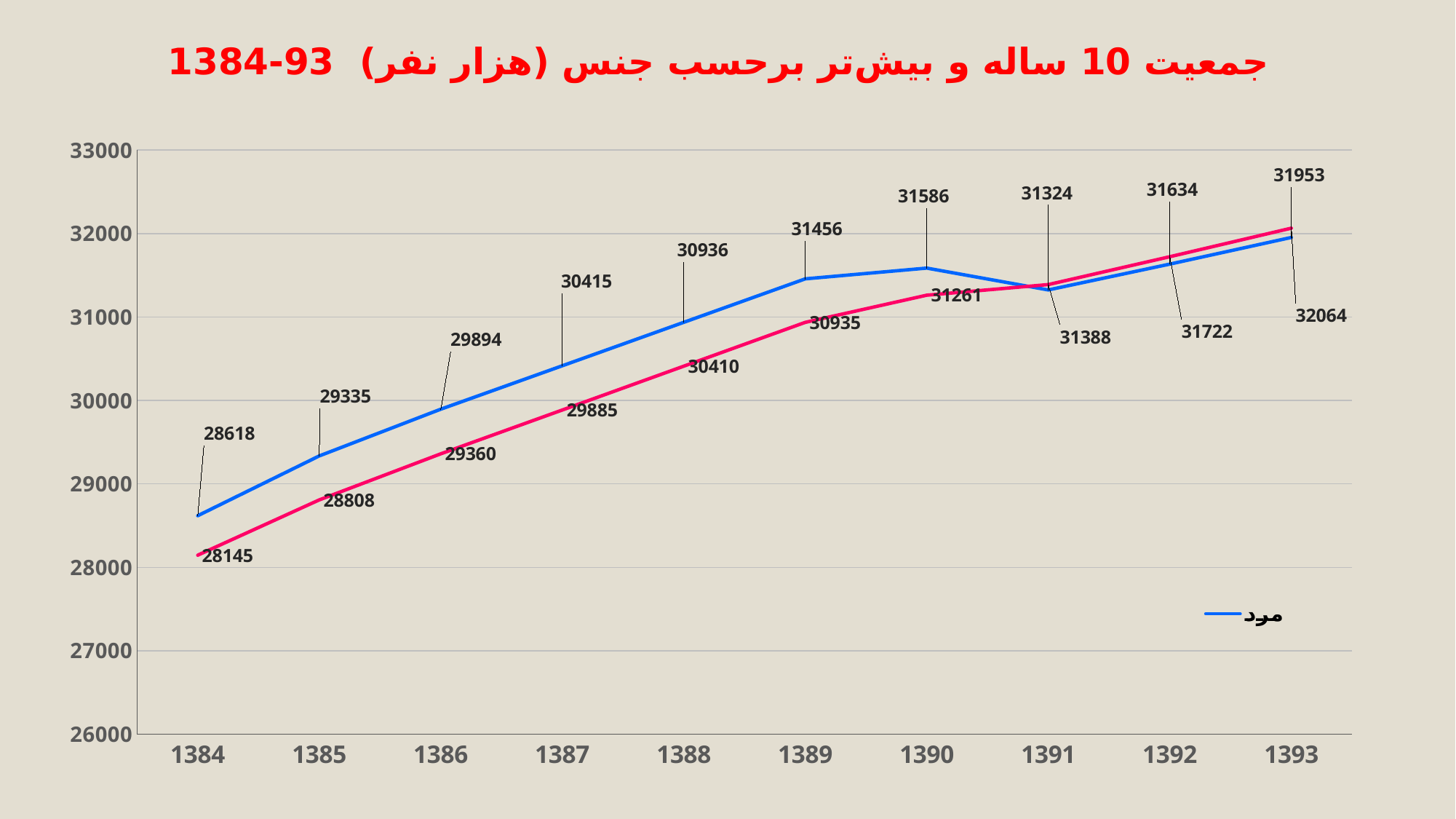
How many years are shown on the x axis? 10 In which year does the مرد series reach its highest value? 1393 By how much did the مرد series increase from 1384 to 1393? 3335 In which year does the مرد series have its lowest value? 1384 What is the value of the pink line in 1393? 32064 What is the value of the مرد series in 1384? 28618 Is the value of the مرد series in 1388 greater or less than 31000? less Does the مرد series rise or fall from 1384 to 1389? rise What is the value of the pink line in 1387? 29885 What kind of chart is shown on the slide? line chart What is the value of the مرد series in 1390? 31586 In 1389, which line has the larger value, the blue مرد line or the pink line? the blue مرد line